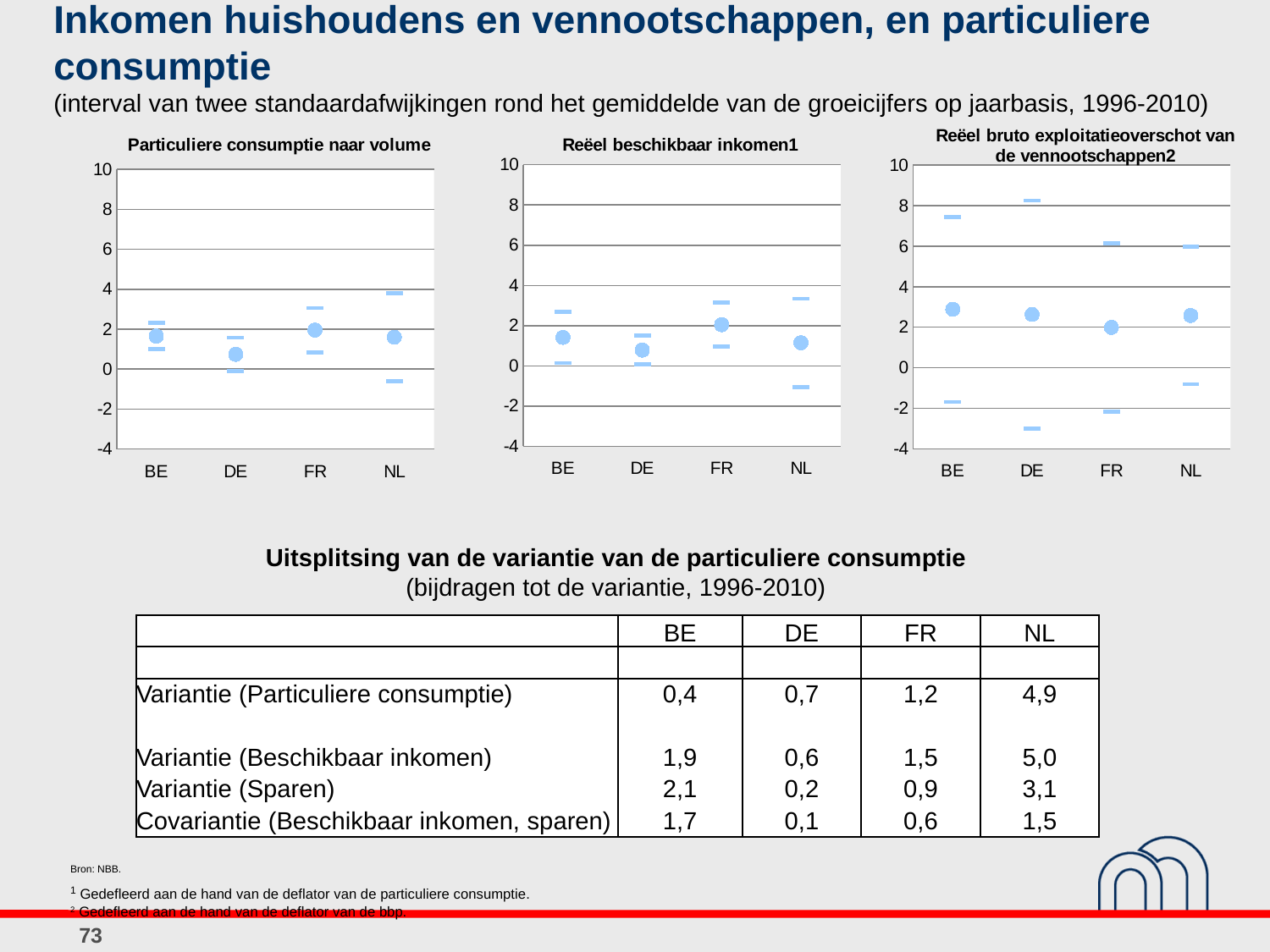
In the 'Particuliere consumptie naar volume' chart, which country has the highest upper interval bound? NL In the 'Reëel bruto exploitatieoverschot van de vennootschappen2' chart, which country has the lowest average (dot) value? FR In the 'Reëel bruto exploitatieoverschot van de vennootschappen2' chart, is the upper interval bound for BE greater or less than 6? greater In the 'Reëel bruto exploitatieoverschot van de vennootschappen2' chart, which country has the highest upper interval bound? DE In the 'Reëel beschikbaar inkomen1' chart, which country has the lowest lower interval bound? NL In the 'Particuliere consumptie naar volume' chart, is the average (dot) value for DE greater or less than 2? less How many countries are shown on the x axis of the 'Particuliere consumptie naar volume' chart? 4 In the 'Reëel bruto exploitatieoverschot van de vennootschappen2' chart, is the lower interval bound for DE greater or less than -2? less What is the title of the middle chart on the slide? Reëel beschikbaar inkomen1 In the 'Reëel beschikbaar inkomen1' chart, which country has the lowest average (dot) value? DE